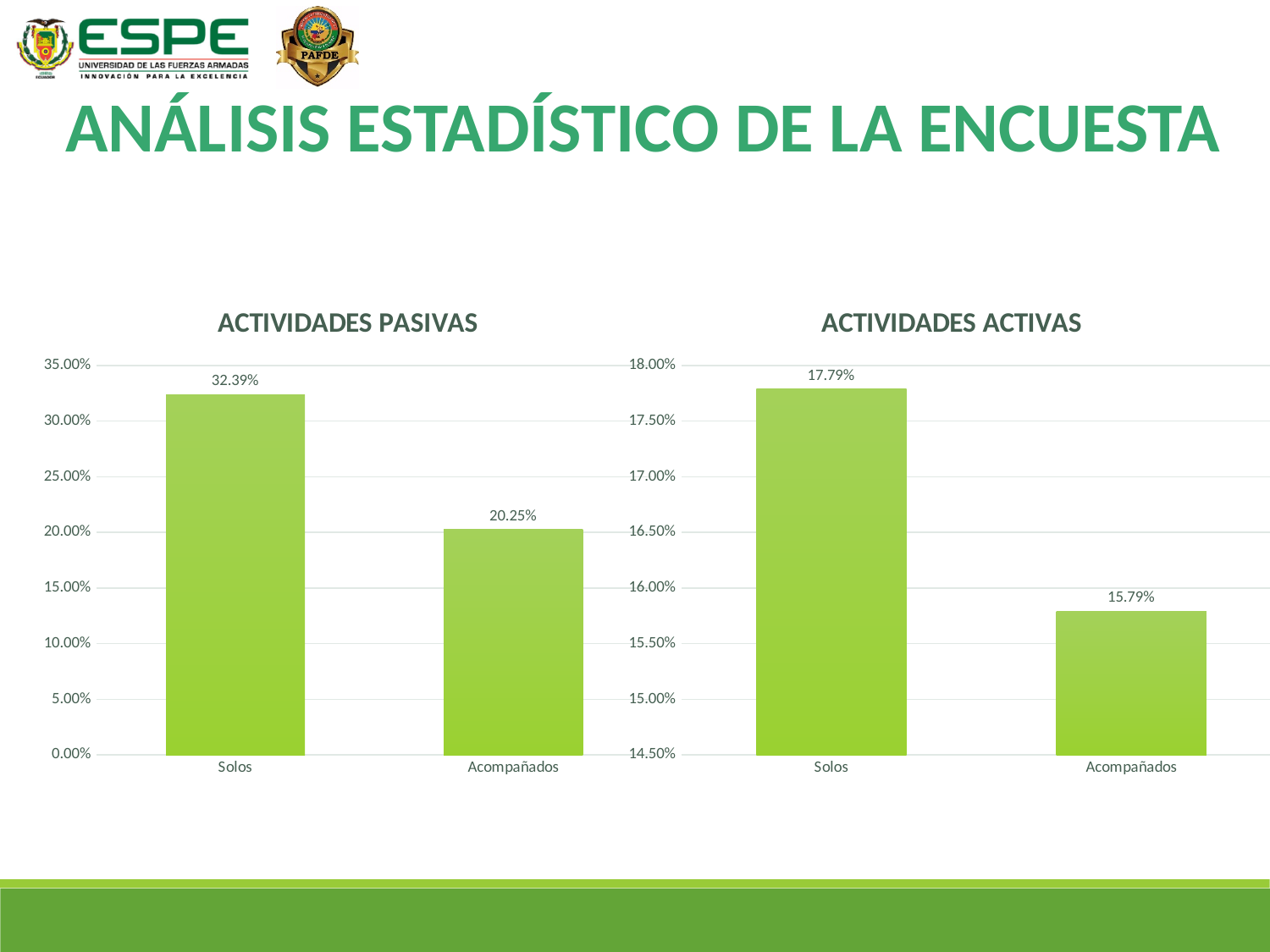
In the ACTIVIDADES PASIVAS chart, what is the difference between the values for Solos and Acompañados? 12.14% In the ACTIVIDADES PASIVAS chart, which category has the highest value? Solos In the ACTIVIDADES ACTIVAS chart, which category has the lowest value? Acompañados In the ACTIVIDADES ACTIVAS chart, is the value for Solos greater or less than 17.50%? greater How many categories does the ACTIVIDADES PASIVAS chart show? 2 In the ACTIVIDADES PASIVAS chart, what is the value for Solos? 32.39% In the ACTIVIDADES ACTIVAS chart, what is the value for Solos? 17.79% In the ACTIVIDADES ACTIVAS chart, what is the value for Acompañados? 15.79% What is the title of the chart on the left side of the slide? ACTIVIDADES PASIVAS What kind of chart is the ACTIVIDADES ACTIVAS chart? Bar chart In the ACTIVIDADES ACTIVAS chart, what is the difference between the values for Solos and Acompañados? 2.00% In the ACTIVIDADES PASIVAS chart, what is the value for Acompañados? 20.25%